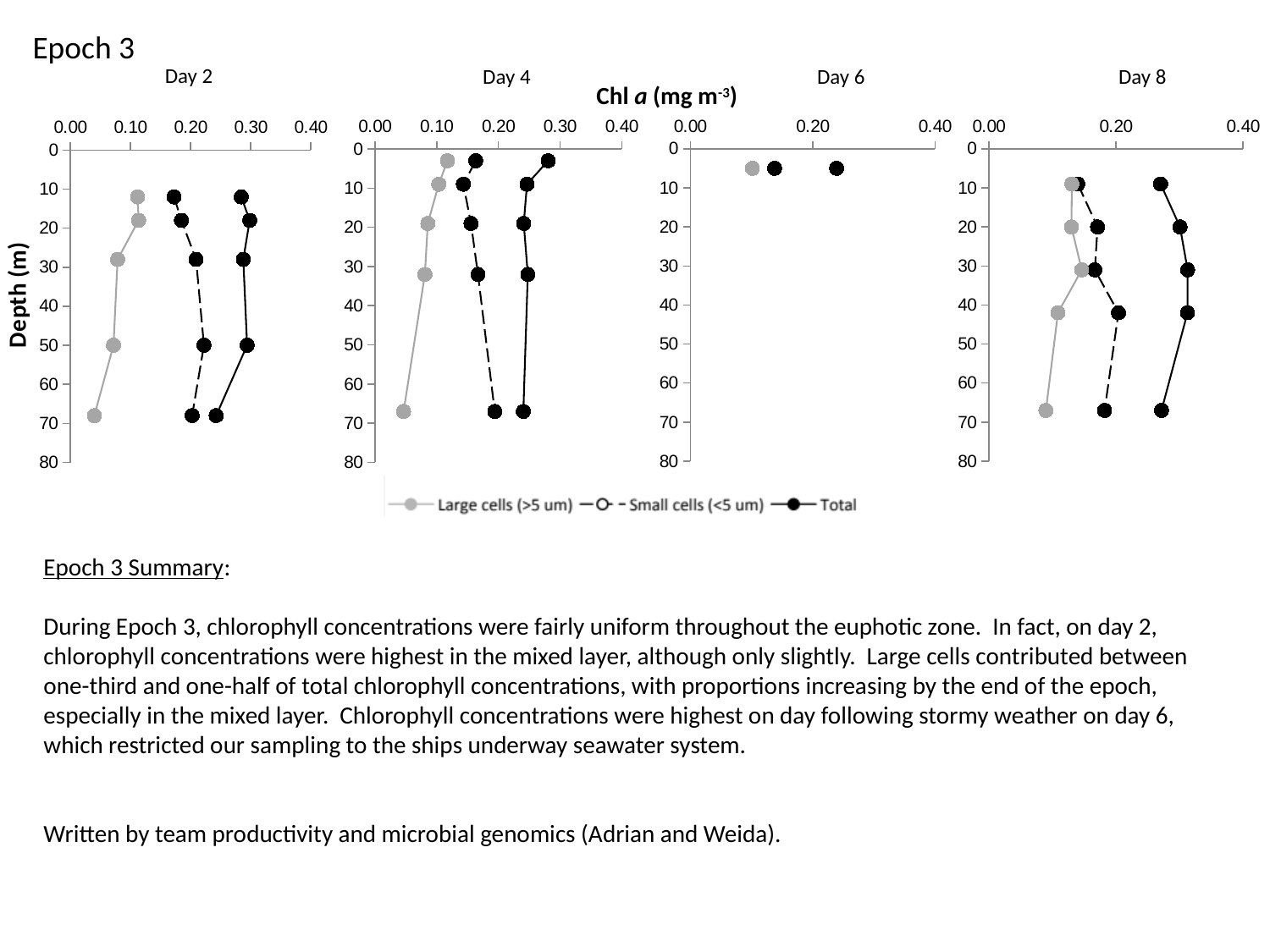
In the Day 8 chart, at about 67 m depth, which is larger, the Total value or the Small cells (<5 um) value? Total In the Day 6 chart, which is larger, the Total value or the Large cells (>5 um) value? Total In the Day 8 chart, is the Total value at 30 m depth greater or less than 0.20? greater In the Day 2 chart, is the Total value at 50 m depth greater or less than 0.20? greater What kind of chart is the Day 2 chart? line chart In the Day 6 chart, is the Total value greater or less than 0.20? greater In the Day 2 chart, how many data points are plotted for the Large cells (>5 um) series? 5 What is the label of the vertical axis on the Day 2 chart? Depth (m) In the Day 8 chart, how many data points are plotted for the Total series? 5 In the Day 6 chart, how many data points are plotted for the Total series? 1 How many series does the legend list for the charts? 3